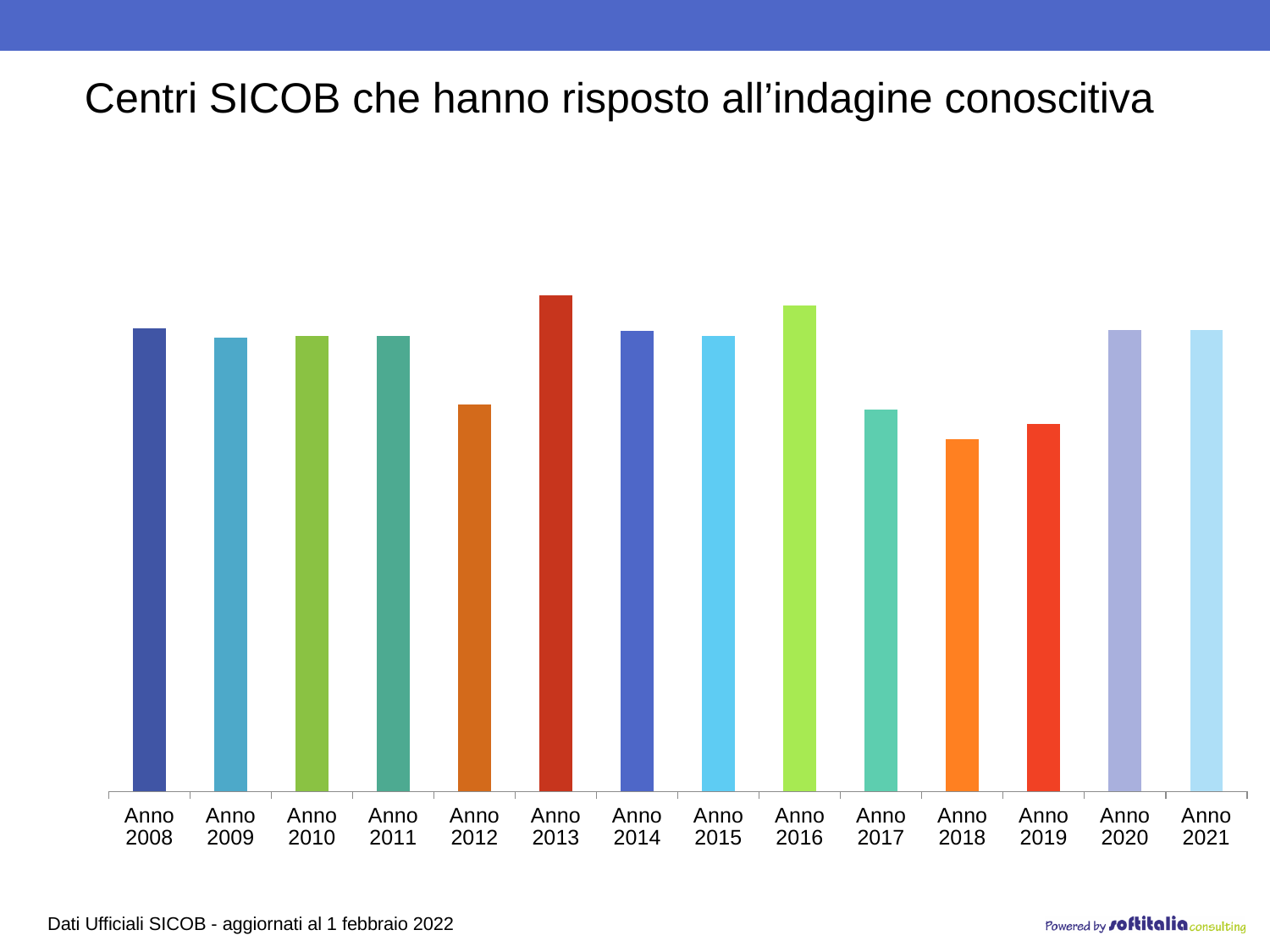
Which year has the highest bar? Anno 2013 What kind of chart is shown on the slide? bar chart Which is larger, the value for Anno 2017 or Anno 2020? Anno 2020 Which year has the lowest bar? Anno 2018 Which is larger, the value for Anno 2016 or Anno 2017? Anno 2016 Which is larger, the value for Anno 2012 or Anno 2013? Anno 2013 How many years (bars) are shown in the chart? 14 What is the title of the chart? Centri SICOB che hanno risposto all'indagine conoscitiva What is the first year shown on the x axis? Anno 2008